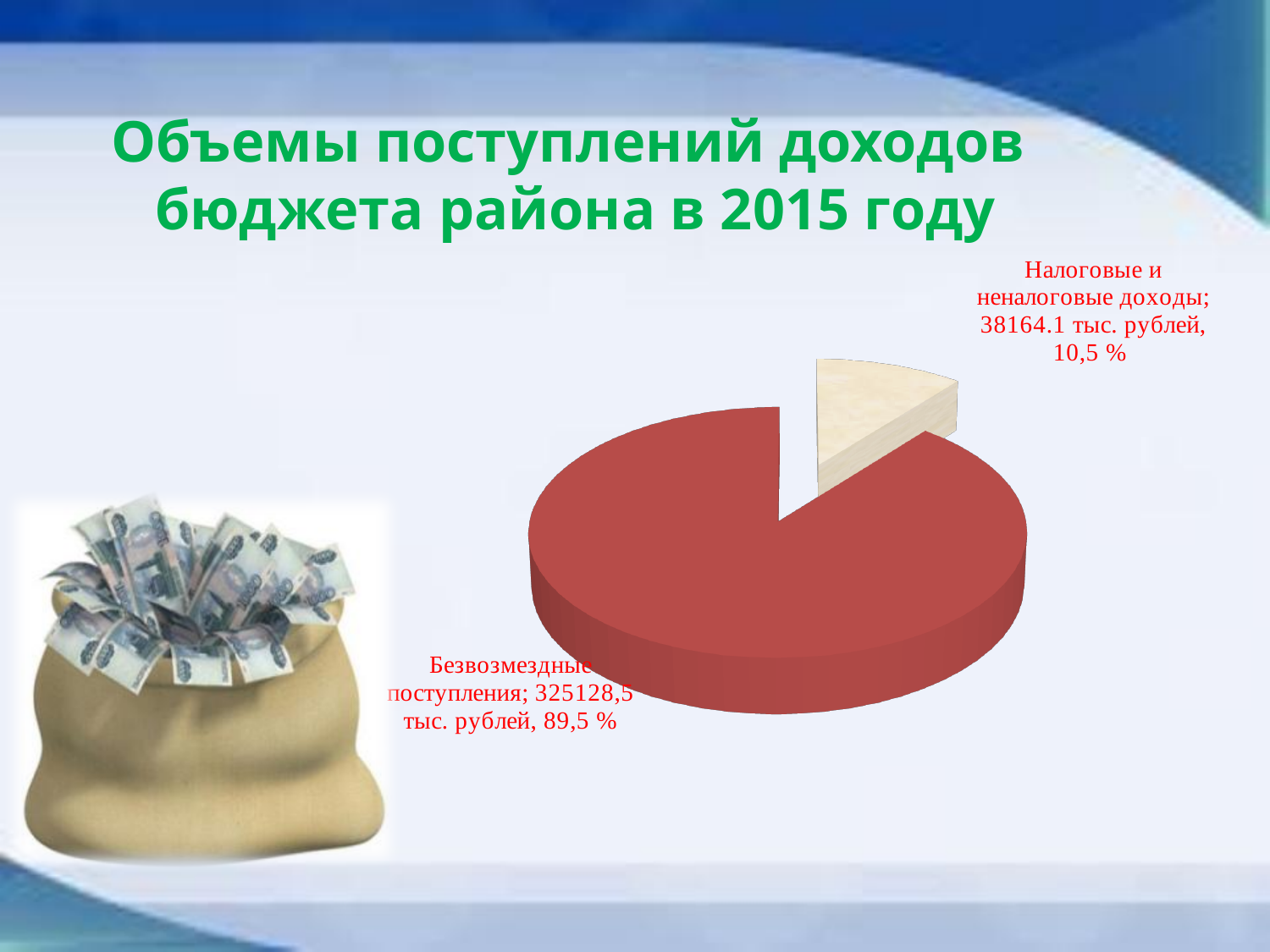
What is the value for Безвозмездные поступления? 325128,5 тыс. рублей What share of the pie does Налоговые и неналоговые доходы represent? 10,5 % What is the difference between Безвозмездные поступления and Налоговые и неналоговые доходы? 286964,4 тыс. рублей What is the title of the slide containing the pie chart? Объемы поступлений доходов бюджета района в 2015 году Which category has the smallest slice of the pie? Налоговые и неналоговые доходы What colour is the slice for Безвозмездные поступления? Red Which category has the largest slice of the pie? Безвозмездные поступления What is the value for Налоговые и неналоговые доходы? 38164.1 тыс. рублей How many slices does the pie chart have? 2 What kind of chart is shown on the slide? Pie chart Which is larger: Безвозмездные поступления or Налоговые и неналоговые доходы? Безвозмездные поступления What share of the pie does Безвозмездные поступления represent? 89,5 %